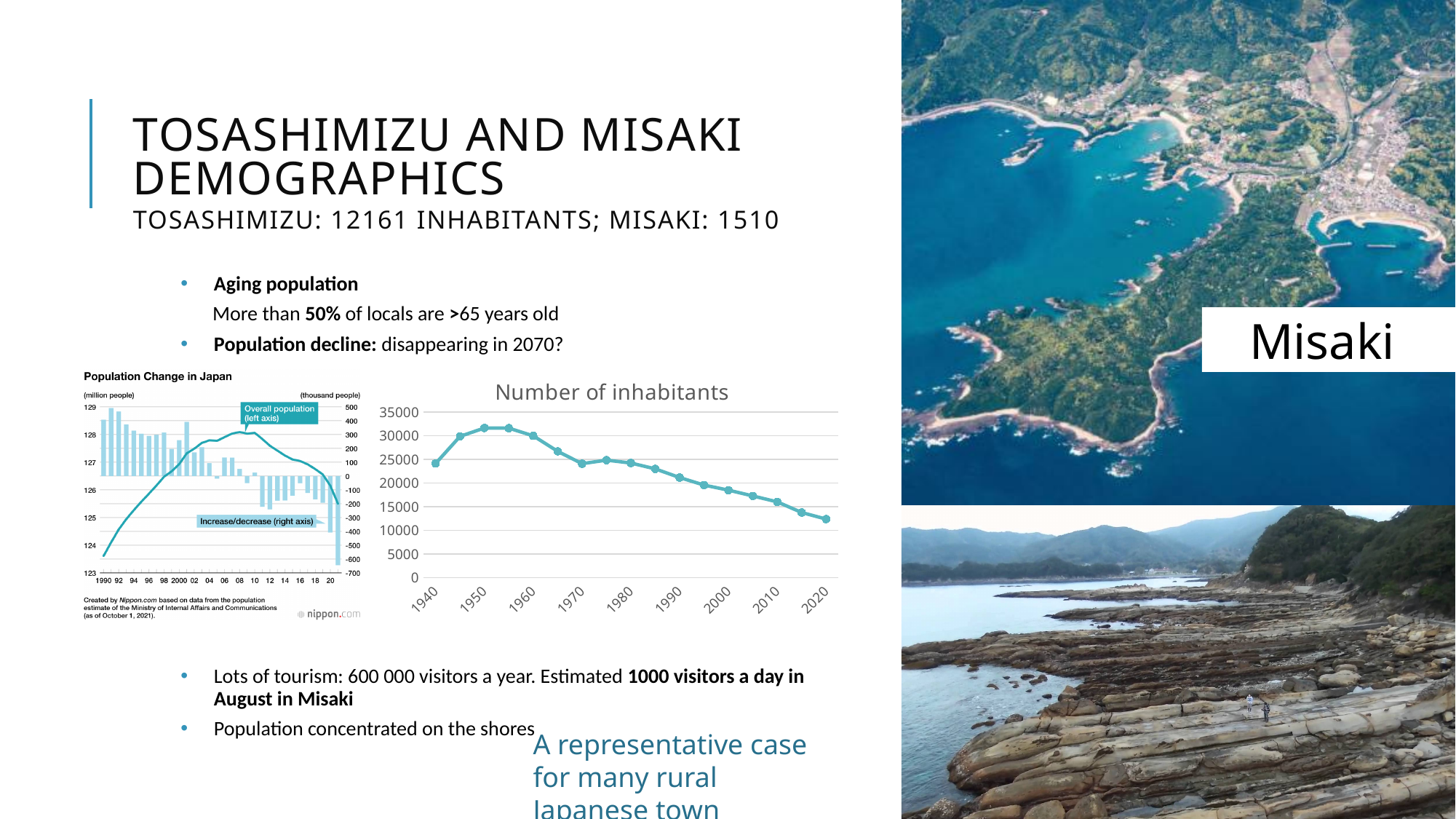
In the "Number of inhabitants" chart, is the value for 2020 greater or less than 15000? less What type of chart is the "Number of inhabitants" chart? Line chart In the "Number of inhabitants" chart, which is larger, the value for 1950 or the value for 1990? 1950 In the "Number of inhabitants" chart, is the value for 1940 greater or less than 20000? greater In the "Population Change in Japan" chart, what unit is shown on the left axis? million people In the "Population Change in Japan" chart, which series is plotted on the right axis? Increase/decrease In the "Number of inhabitants" chart, which year has the lowest number of inhabitants? 2020 In the "Number of inhabitants" chart, is the value for 1950 greater or less than 30000? greater How many data points are plotted in the "Number of inhabitants" chart? 17 In the "Number of inhabitants" chart, do the values rise or fall between 1960 and 2020? fall In the "Number of inhabitants" chart, which is larger, the value for 1940 or the value for 2020? 1940